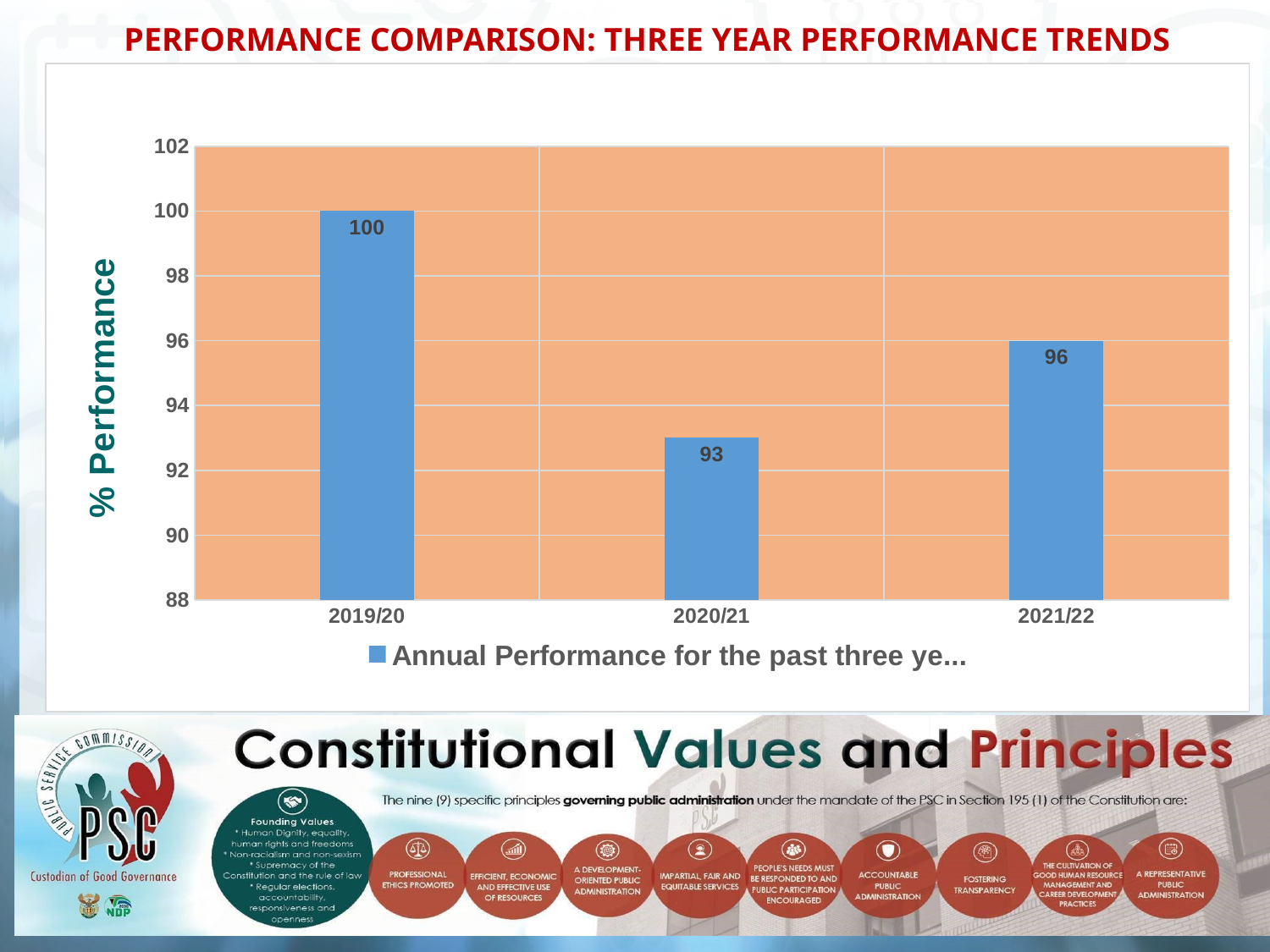
What kind of chart is shown on the slide? bar chart Which year has the lowest % Performance? 2020/21 What is the difference in % Performance between 2019/20 and 2020/21? 7 How many years are shown on the x axis? 3 What is the label of the y axis? % Performance Which year has a higher % Performance, 2020/21 or 2021/22? 2021/22 What is the difference in % Performance between 2021/22 and 2020/21? 3 What is the % Performance value for 2020/21? 93 What is the % Performance value for 2019/20? 100 Which year has the highest % Performance? 2019/20 What is the % Performance value for 2021/22? 96 Is the value for 2020/21 greater or less than 94? less